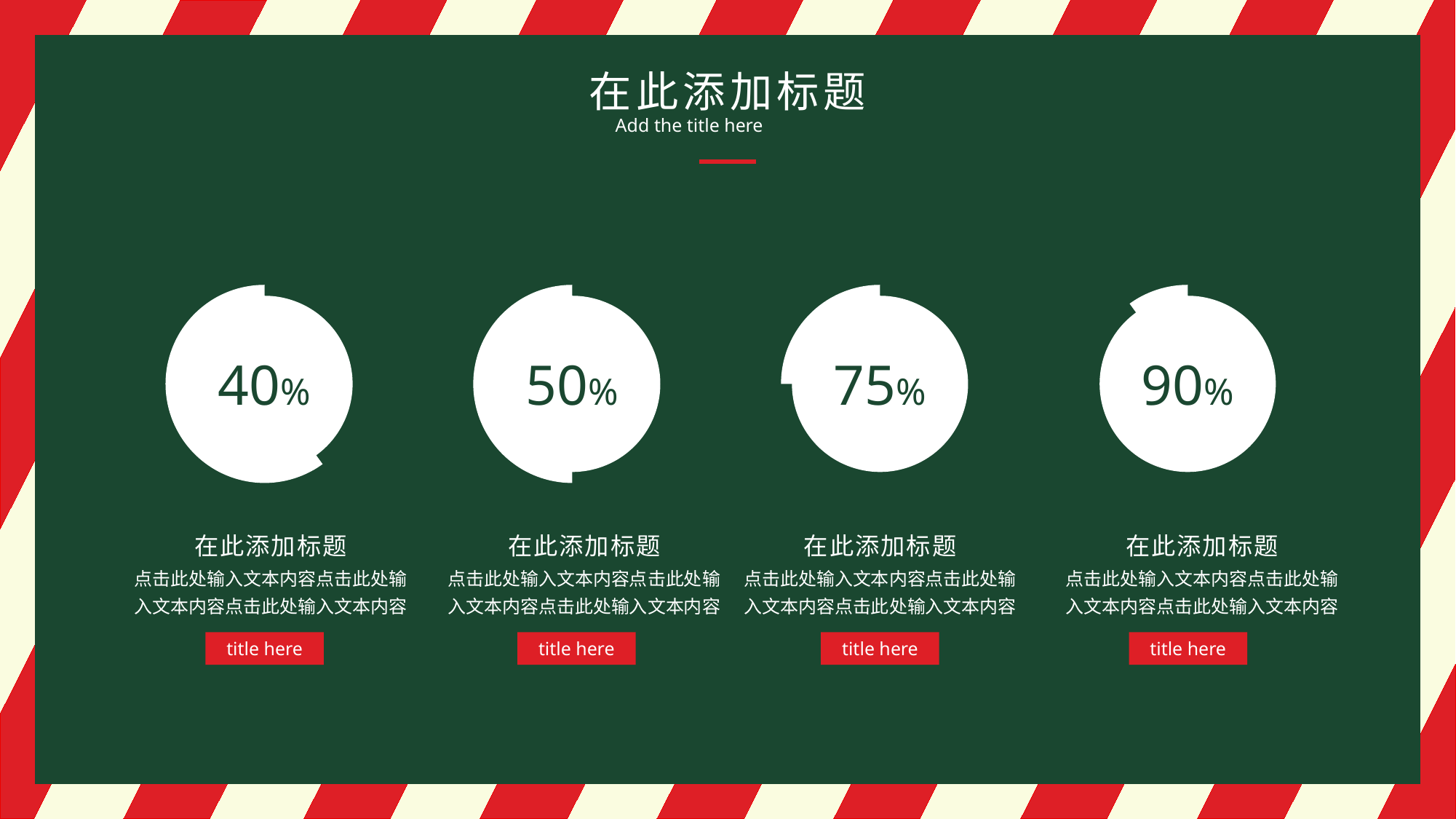
Do the values in the circle charts rise or fall from left to right across the slide? Rise Which of the four circle charts shows the lowest value? The leftmost one (40%) What is the difference between the values in the third and second circle charts from the left? 25% What value is shown in the second circle chart from the left? 50% Which is larger, the value in the second circle chart or the value in the third circle chart from the left? The third (75%) How many circle charts are shown on the slide? 4 What value is shown in the third circle chart from the left? 75% What value is shown in the leftmost circle chart? 40% What is the difference between the value in the rightmost circle chart and the value in the leftmost circle chart? 50% What value is shown in the rightmost circle chart? 90% What is the English subtitle shown under the main title of the slide? Add the title here Which of the four circle charts shows the highest value? The rightmost one (90%)